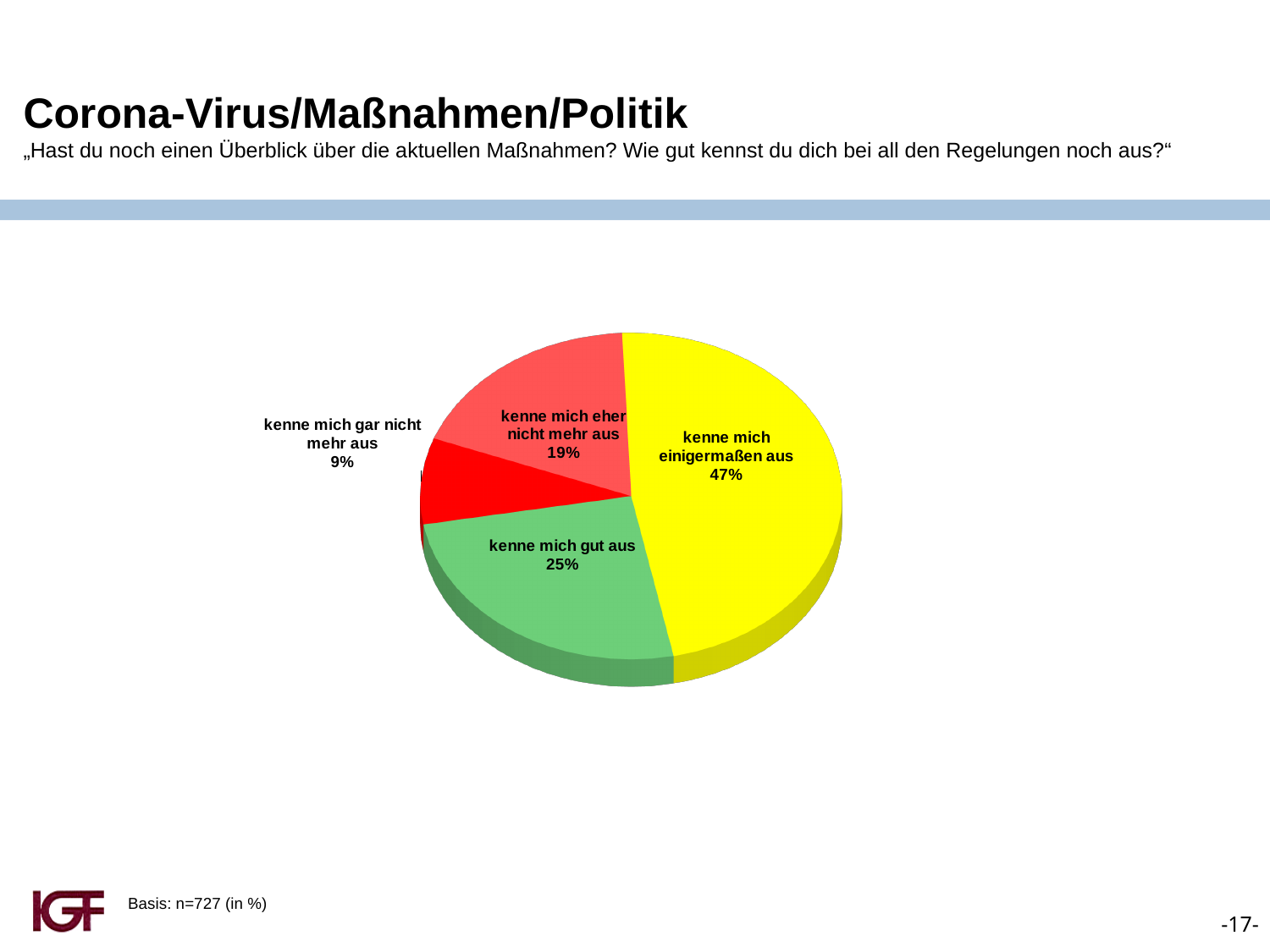
What is the difference in percentage points between "kenne mich einigermaßen aus" and "kenne mich gut aus"? 22 Which answer category has the largest slice of the pie? kenne mich einigermaßen aus Which is larger: the share for "kenne mich eher nicht mehr aus" or for "kenne mich gar nicht mehr aus"? kenne mich eher nicht mehr aus What kind of chart is shown on the slide? pie chart What share of respondents answered "kenne mich gut aus"? 25% How many slices does the pie chart have? 4 What colour is the slice for "kenne mich gut aus"? green Which answer category has the smallest slice of the pie? kenne mich gar nicht mehr aus What share of respondents answered "kenne mich gar nicht mehr aus"? 9% What share of respondents answered "kenne mich eher nicht mehr aus"? 19% What is the sample size (Basis) stated on the slide? n=727 What share of respondents answered "kenne mich einigermaßen aus"? 47%